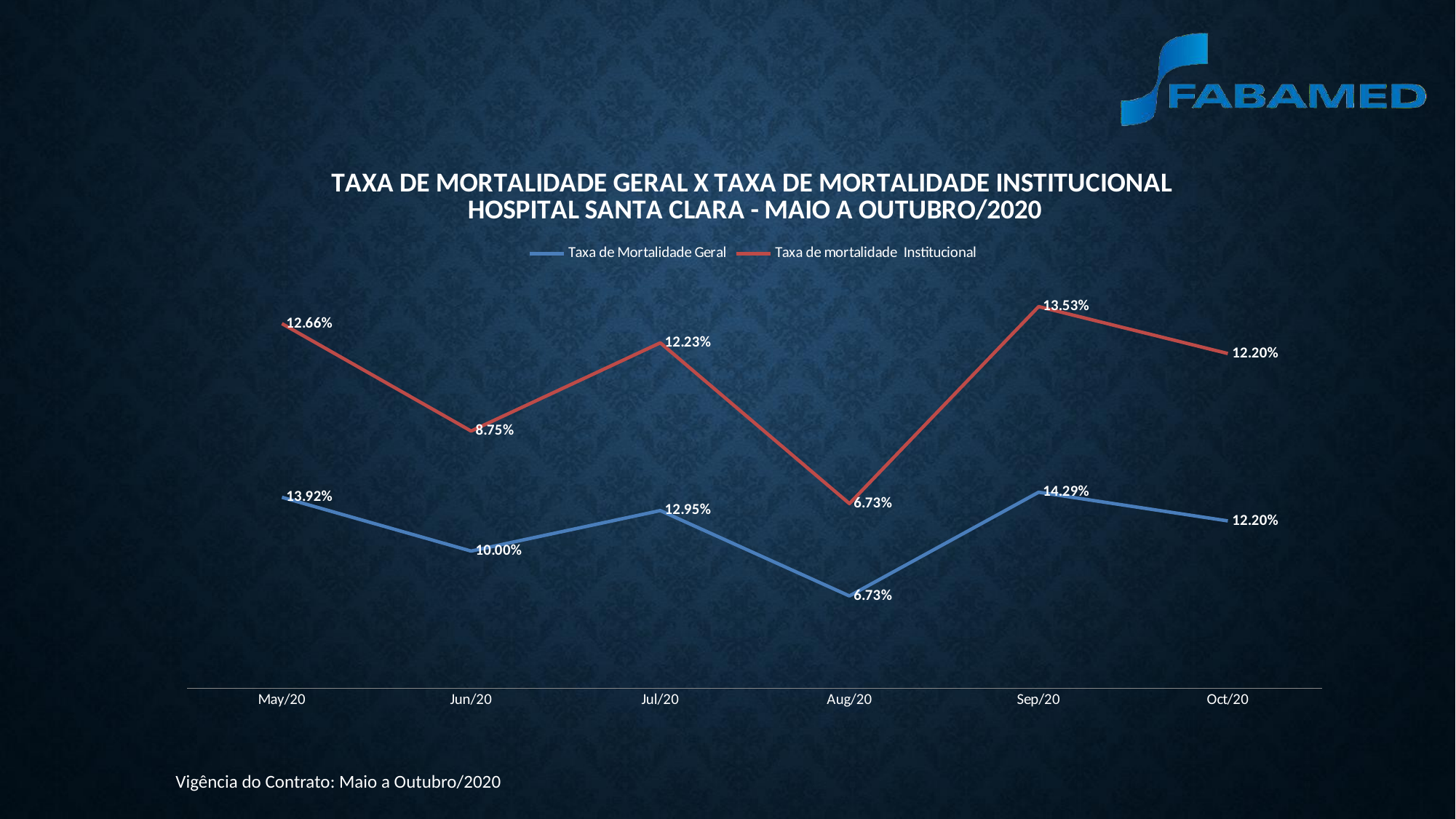
Which is larger in Jul/20: the Taxa de Mortalidade Geral or the Taxa de mortalidade Institucional? Taxa de Mortalidade Geral In which month is the Taxa de mortalidade Institucional lowest? Aug/20 Does the Taxa de mortalidade Institucional rise or fall from Sep/20 to Oct/20? Fall What is the Taxa de Mortalidade Geral for Sep/20? 14.29% What is the difference between the Taxa de Mortalidade Geral and the Taxa de mortalidade Institucional in May/20? 1.26% What is the Taxa de mortalidade Institucional for Jun/20? 8.75% How many series does the legend list? 2 How many months are plotted along the x axis? 6 What is the Taxa de mortalidade Institucional for May/20? 12.66% Which colour is used for the Taxa de mortalidade Institucional line? Red What type of chart is shown on the slide? Line chart In which month is the Taxa de Mortalidade Geral highest? Sep/20